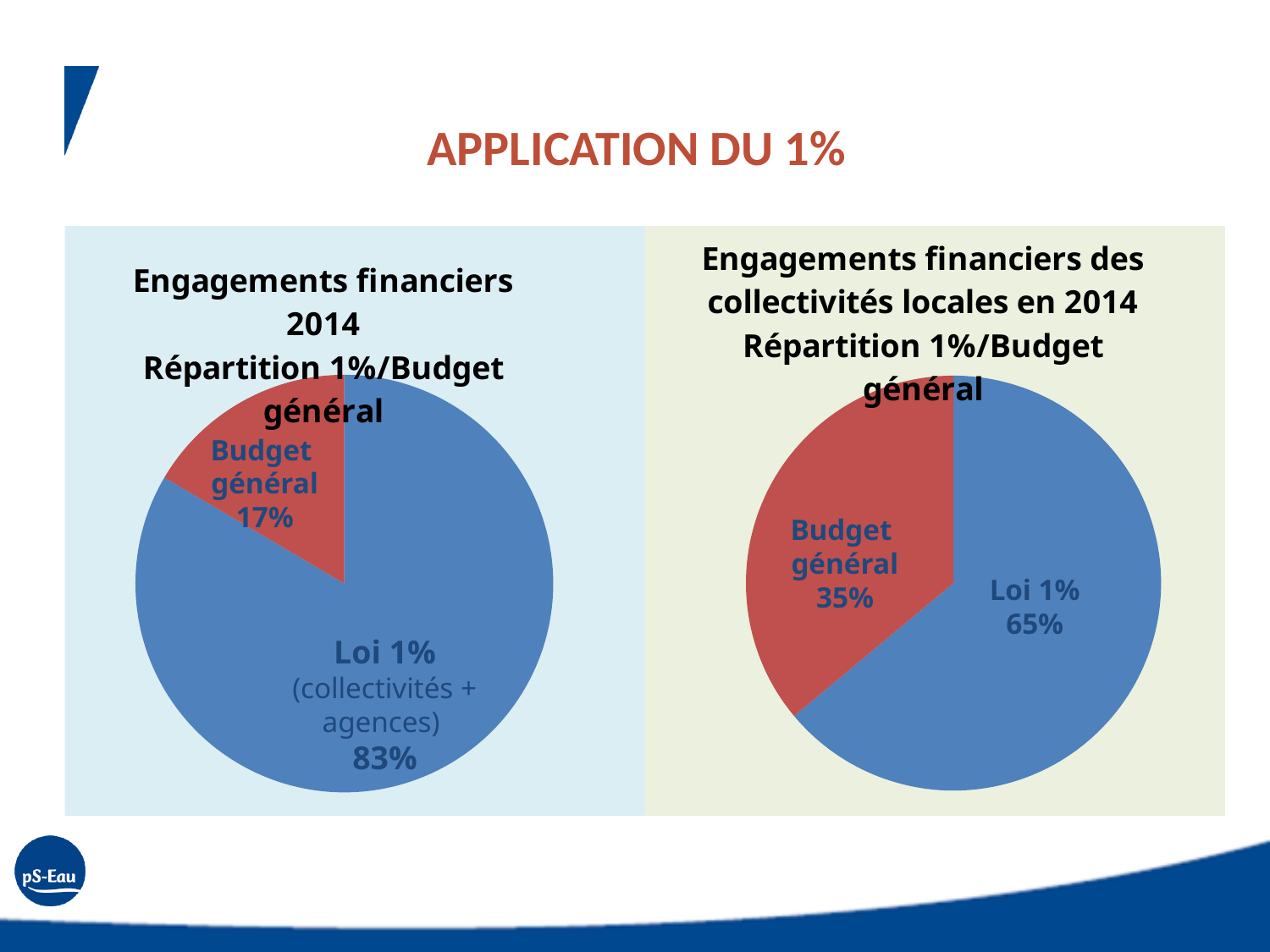
In the left chart, what is the difference in percentage points between Loi 1% and Budget général? 66 percentage points In the left chart (Engagements financiers 2014), what share does Budget général have? 17% In the left chart (Engagements financiers 2014), what share does Loi 1% (collectivités + agences) have? 83% In the left chart, which slice is the largest? Loi 1% (collectivités + agences) What type of chart is used on the left side of the slide? Pie chart In the right chart (Engagements financiers des collectivités locales en 2014), what share does Budget général have? 35% What colour is the Budget général slice in both charts? Red In the right chart, which slice is the smallest? Budget général How many slices does the right chart have? 2 In the right chart, what is the difference in percentage points between Loi 1% and Budget général? 30 percentage points Is the Budget général share larger in the left chart or in the right chart? Right chart